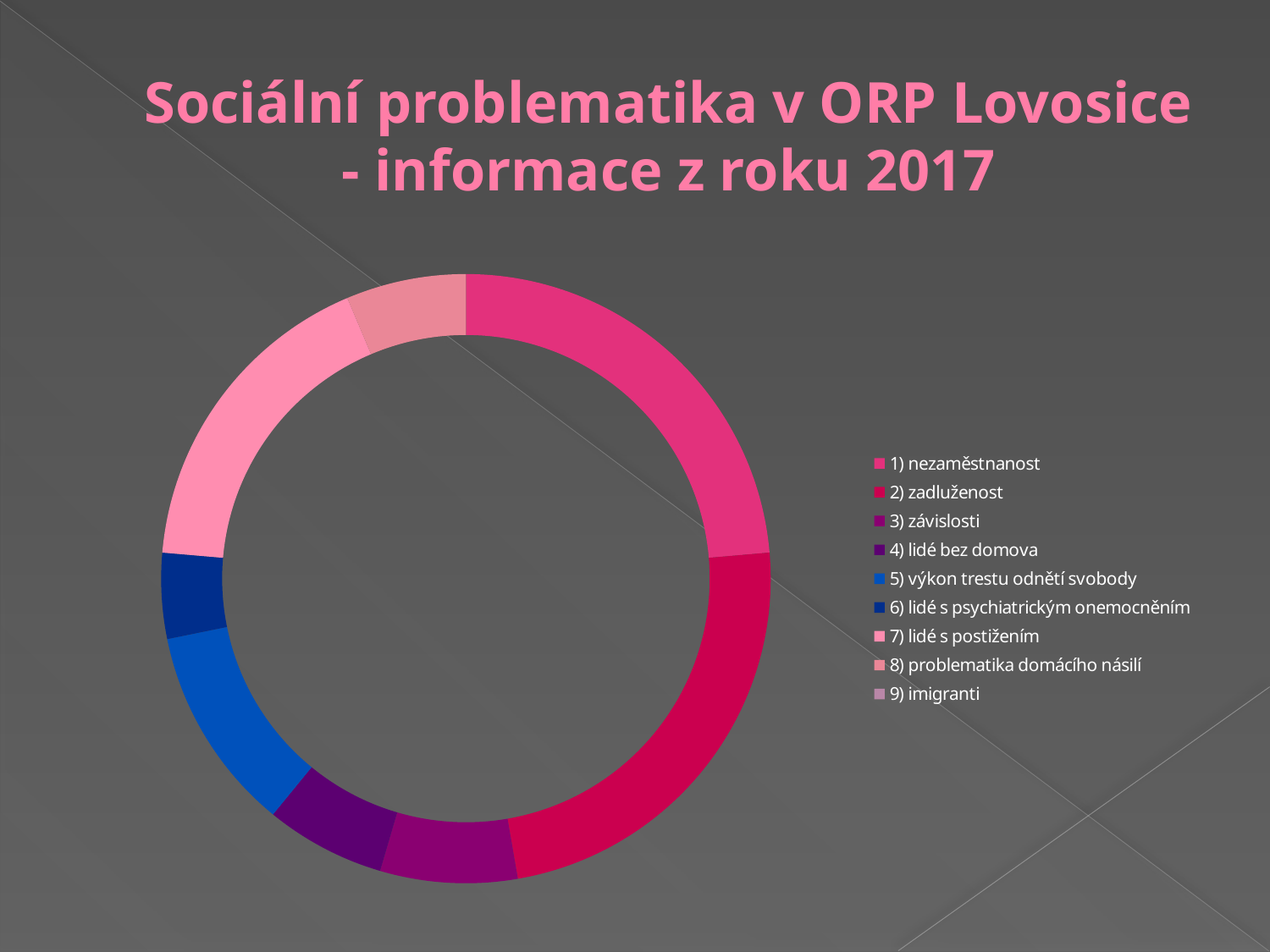
Which is larger in the chart: the slice for 5) výkon trestu odnětí svobody or the slice for 6) lidé s psychiatrickým onemocněním? 5) výkon trestu odnětí svobody What colour is the legend marker for 5) výkon trestu odnětí svobody? blue What kind of chart is shown on the slide? doughnut chart Which legend entry is listed last in the chart's legend? 9) imigranti What is the title of the slide containing the chart? Sociální problematika v ORP Lovosice - informace z roku 2017 Which is larger in the chart: the slice for 2) zadluženost or the slice for 3) závislosti? 2) zadluženost Which is larger in the chart: the slice for 7) lidé s postižením or the slice for 4) lidé bez domova? 7) lidé s postižením How many categories does the legend of the chart list? 9